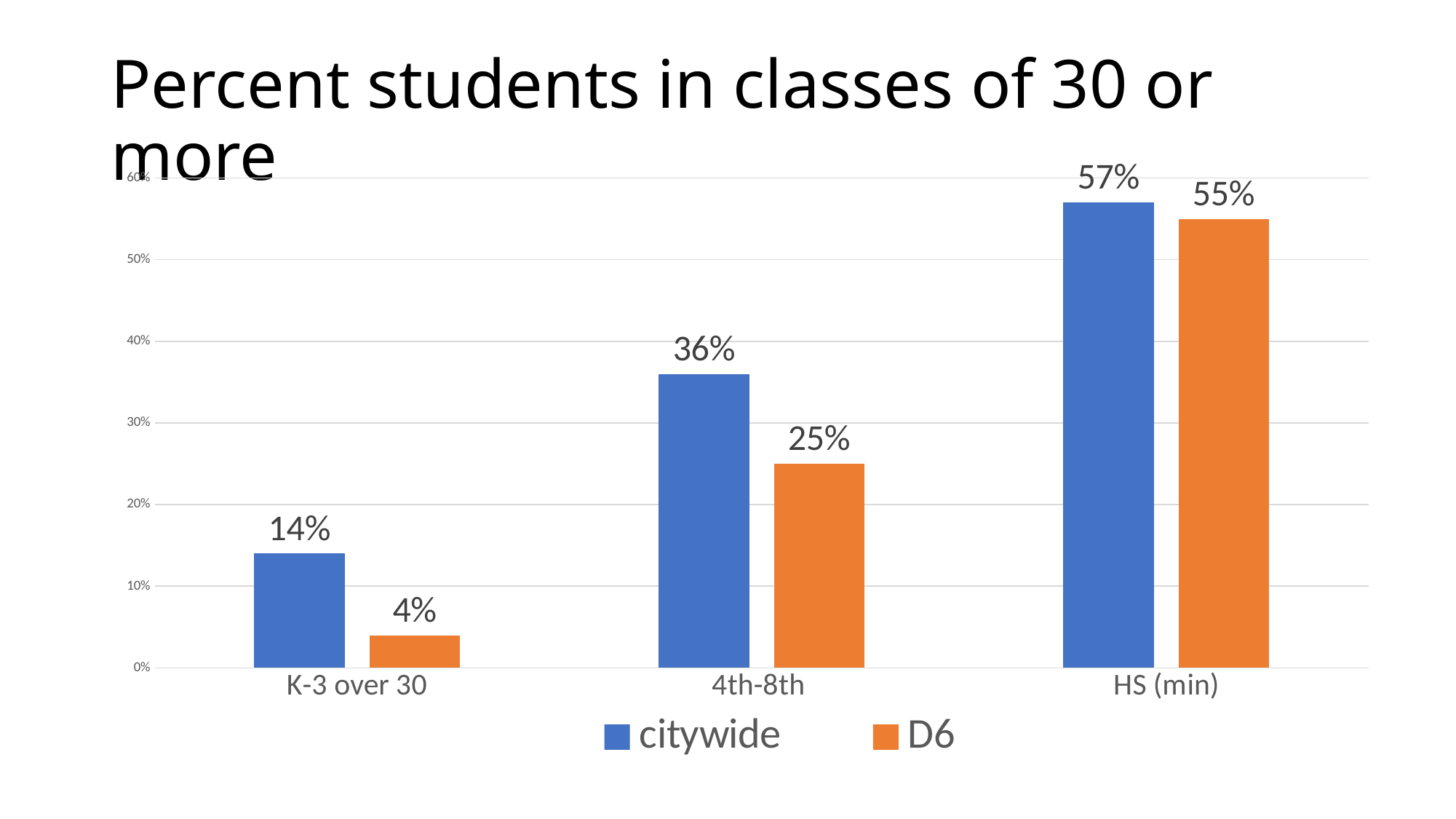
What kind of chart is shown on the slide? bar chart Which is larger for K-3 over 30, the citywide value or the D6 value? citywide Do the citywide values rise or fall from K-3 over 30 to HS (min)? rise What is the D6 value for 4th-8th? 25% What is the citywide value for K-3 over 30? 14% What is the D6 value for HS (min)? 55% Which category has the lowest D6 value? K-3 over 30 What is the difference between the citywide and D6 values for 4th-8th? 11% How many series does the legend list? 2 Is the citywide value for HS (min) greater or less than 50%? greater How many categories are shown on the x axis? 3 Which category has the highest citywide value? HS (min)